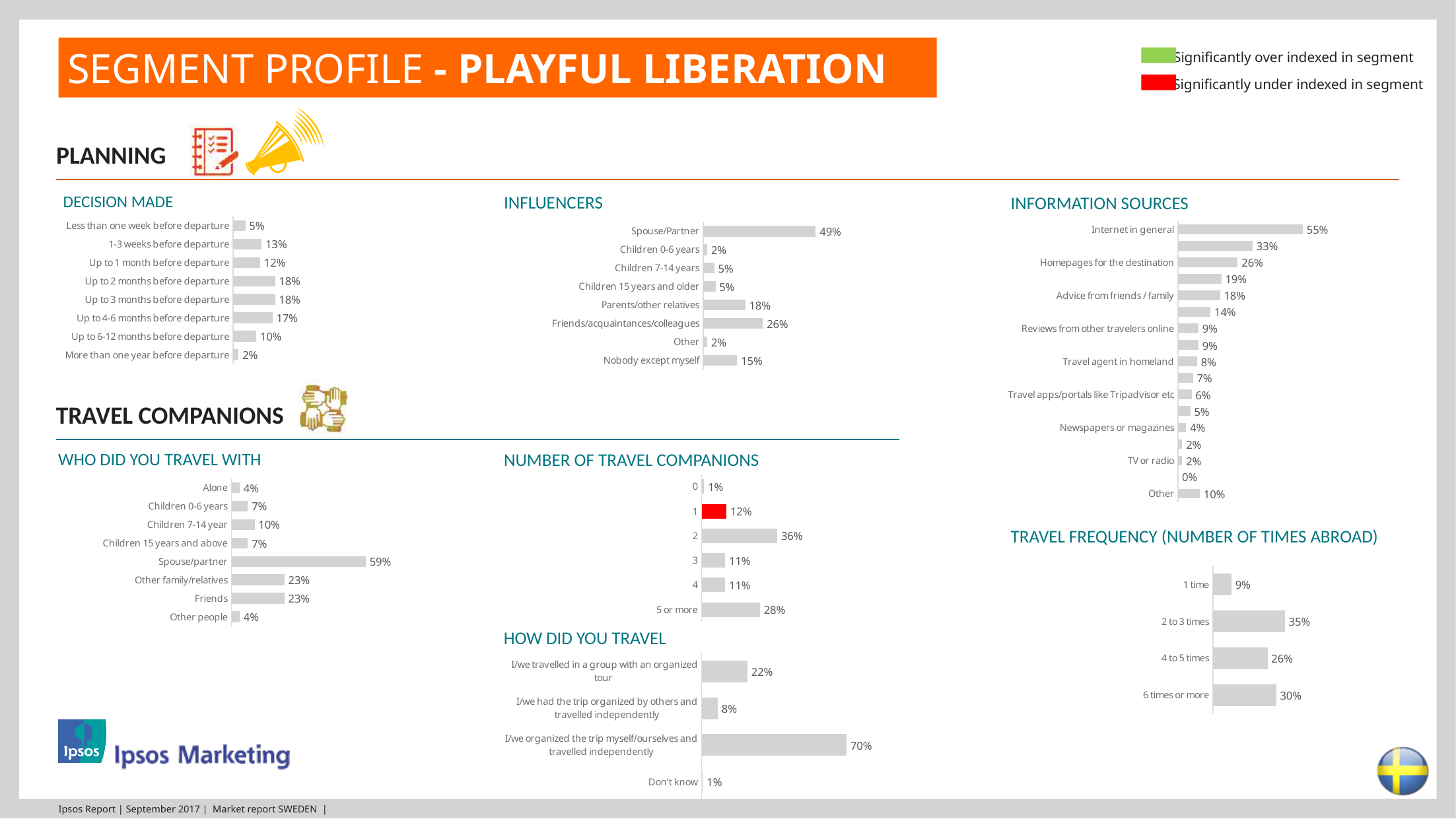
In the INFORMATION SOURCES chart, what is the value for 'Internet in general'? 55% In the DECISION MADE chart, how many categories are shown? 8 In the INFLUENCERS chart, what is the difference between 'Friends/acquaintances/colleagues' and 'Parents/other relatives'? 8% In the HOW DID YOU TRAVEL chart, what is the value for 'I/we organized the trip myself/ourselves and travelled independently'? 70% In the WHO DID YOU TRAVEL WITH chart, which category has the highest value? Spouse/partner In the INFORMATION SOURCES chart, which is larger: 'Travel agent in homeland' or 'Newspapers or magazines'? Travel agent in homeland In the WHO DID YOU TRAVEL WITH chart, what is the value for 'Other family/relatives'? 23% In the INFLUENCERS chart, which category has the highest value? Spouse/Partner In the DECISION MADE chart, what is the value for 'Up to 4-6 months before departure'? 17% In the TRAVEL FREQUENCY (NUMBER OF TIMES ABROAD) chart, what is the difference between '2 to 3 times' and '6 times or more'? 5% In the NUMBER OF TRAVEL COMPANIONS chart, which bar is coloured red? 1 In the NUMBER OF TRAVEL COMPANIONS chart, which category has the lowest value? 0